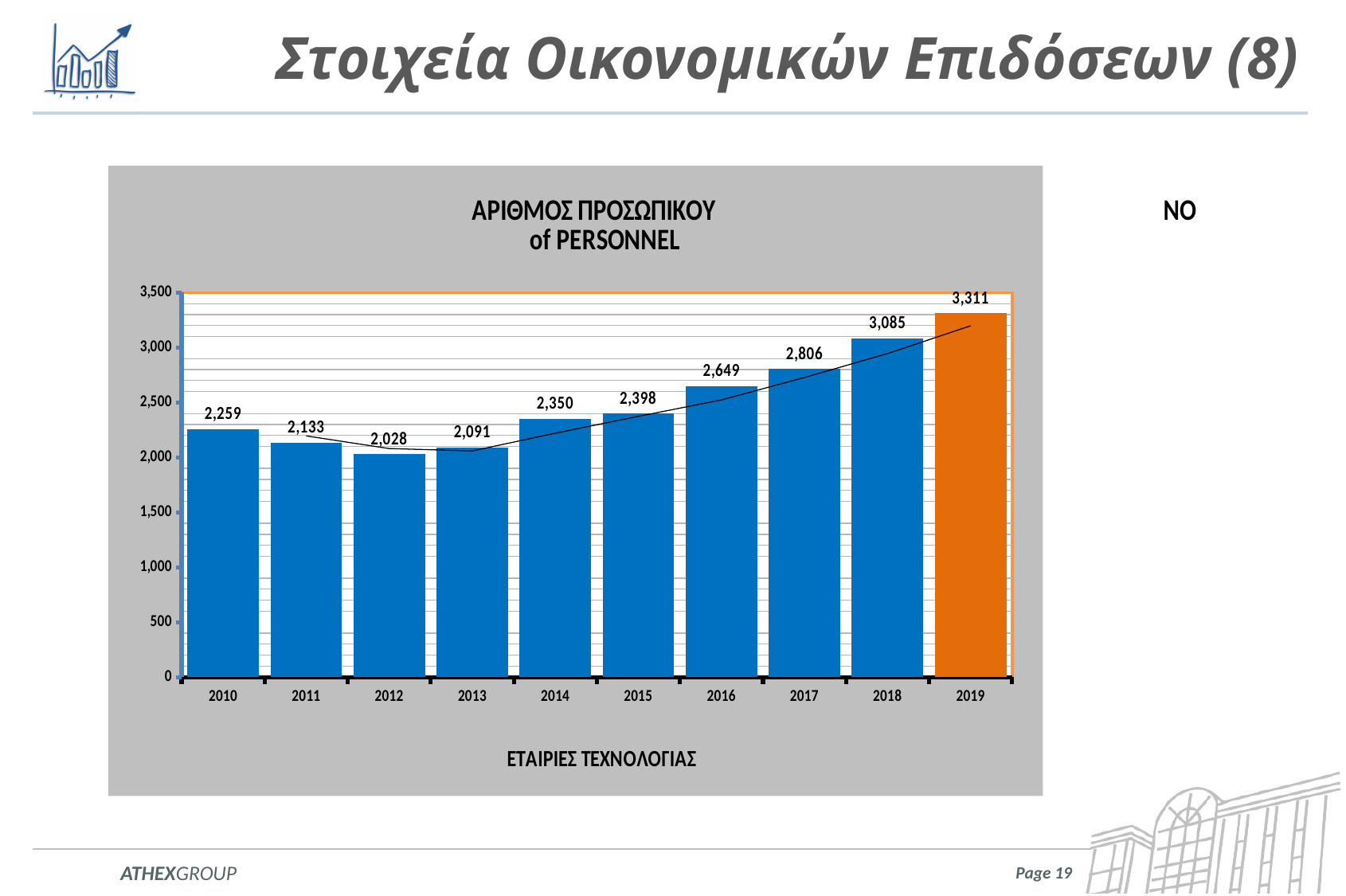
Is the value for 2017 greater or less than 3,000? less Which year has the highest number of personnel? 2019 Which year has the lowest number of personnel? 2012 Which year has more personnel, 2013 or 2014? 2014 What is the number of personnel shown for 2019? 3,311 What kind of chart is shown on the slide? bar chart What is the number of personnel shown for 2015? 2,398 What is the difference in personnel between 2010 and 2012? 231 Which bar is coloured orange instead of blue? 2019 What is the number of personnel shown for 2010? 2,259 What is the difference in personnel between 2019 and 2018? 226 How many years are shown on the x axis? 10